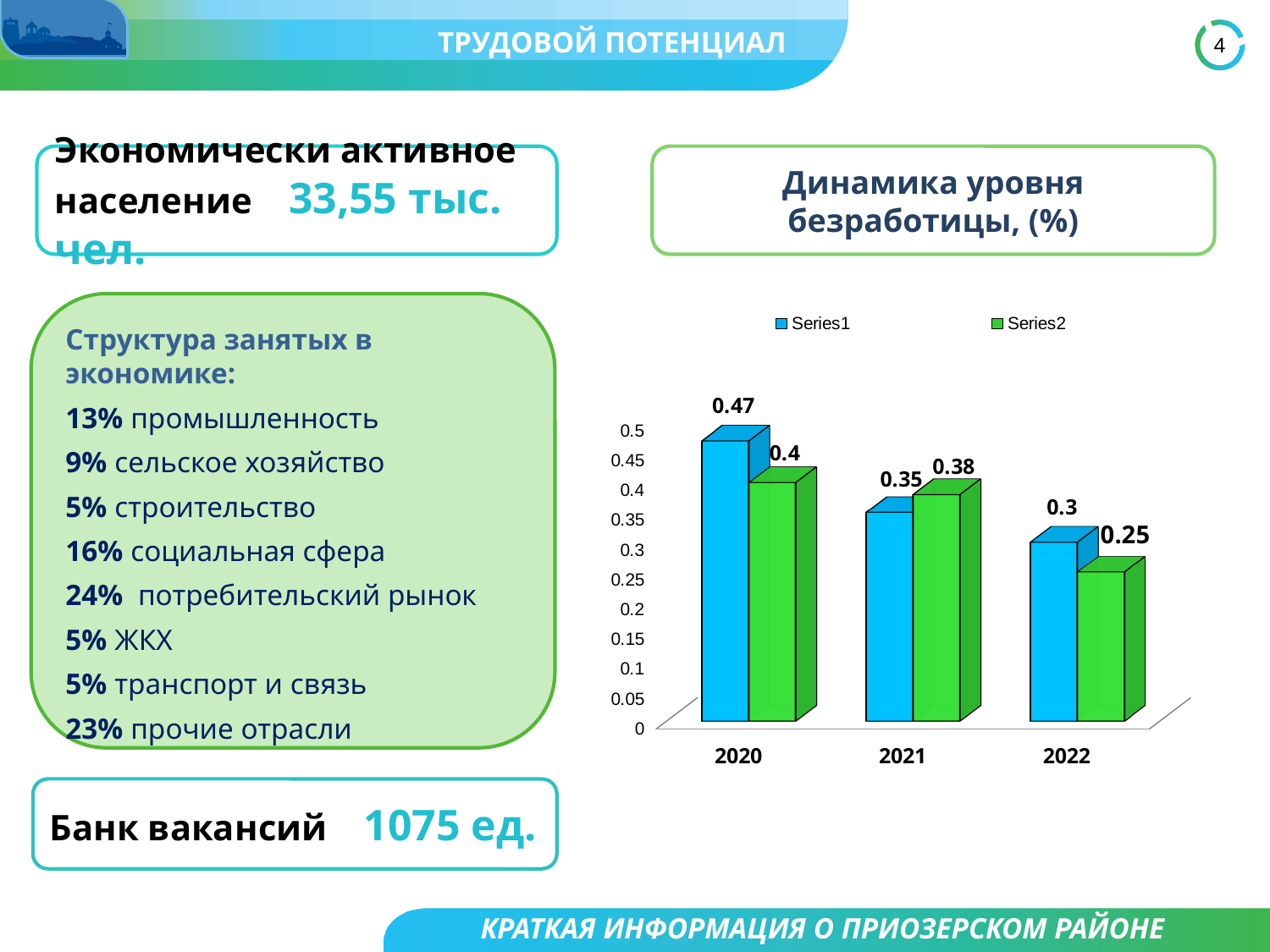
Which is larger in 2021: Series1 or Series2? Series2 How many series does the chart legend list? 2 What is the value of Series2 for 2022? 0.25 What is the value of Series1 for 2020? 0.47 What kind of chart is shown on the slide? bar chart What is the value of Series2 for 2021? 0.38 How many years are shown on the x axis of the chart? 3 Which year has the lowest Series2 value? 2022 Do the Series1 values rise or fall from 2020 to 2022? fall Which year has the highest Series1 value? 2020 Is the Series1 value for 2022 greater or less than 0.4? less What is the difference between the Series1 values for 2020 and 2022? 0.17